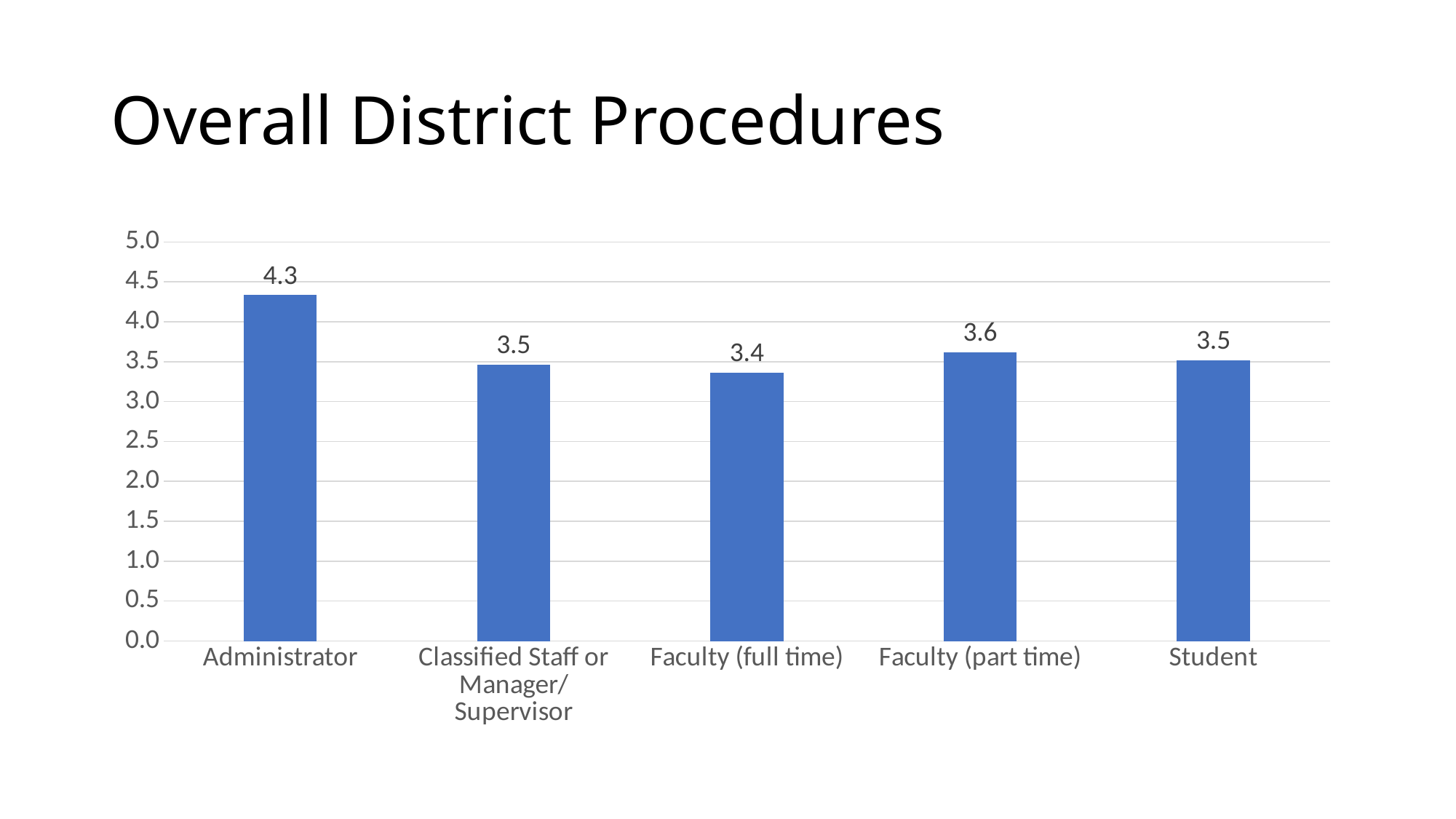
Is the value for Administrator greater or less than 4.0? greater What is the title of the slide? Overall District Procedures Which is larger, the value for Administrator or the value for Faculty (part time)? Administrator What is the value for Faculty (part time)? 3.6 Which category has the highest value? Administrator How many categories are shown on the x axis? 5 Which category has the lowest value? Faculty (full time) What is the value for Student? 3.5 What is the value for Faculty (full time)? 3.4 What is the difference between the values for Administrator and Faculty (full time)? 0.9 What is the value for Administrator? 4.3 What kind of chart is shown on the slide? bar chart